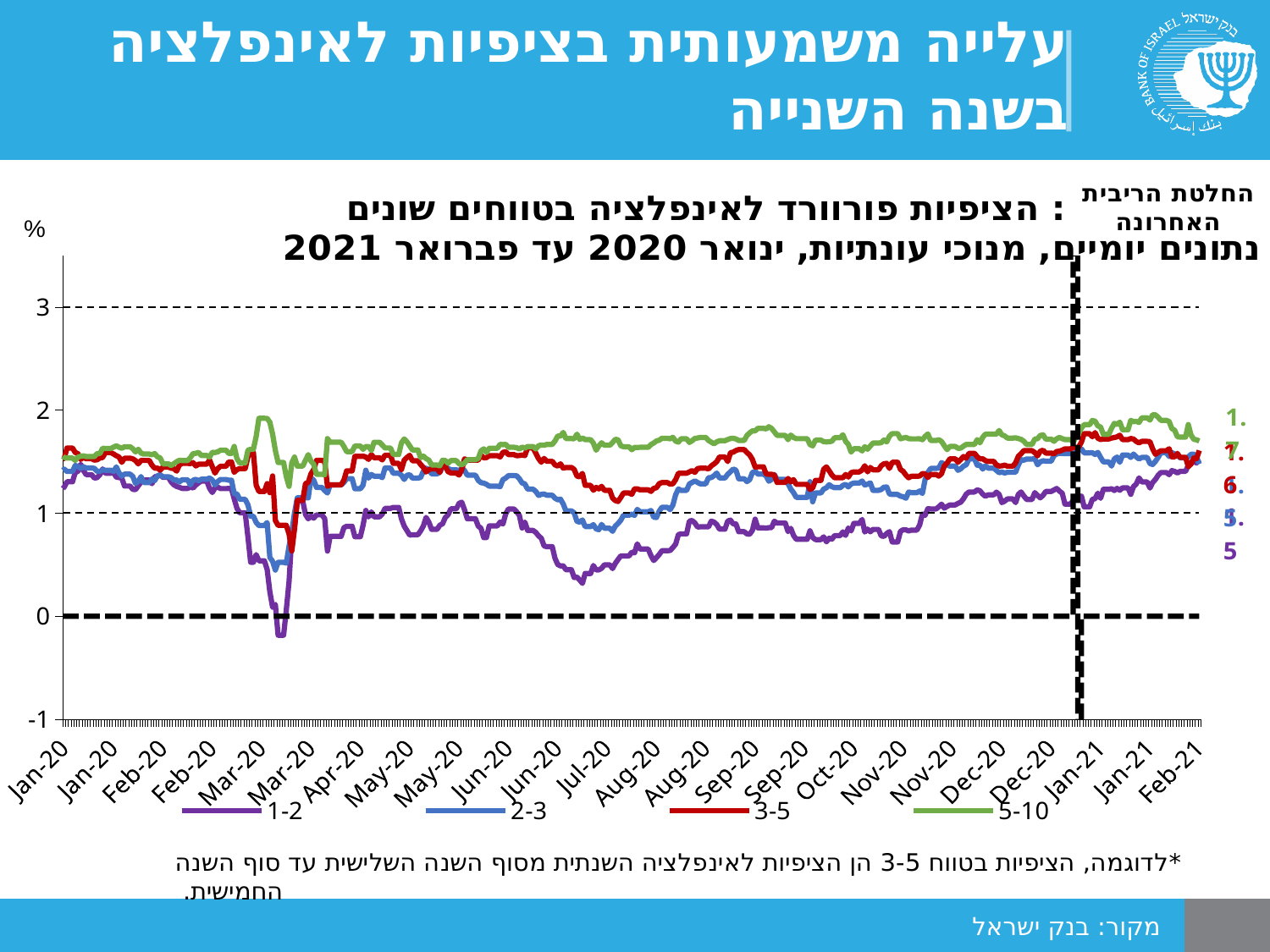
Is the lowest point of the 1-2 series in Mar-20 greater or less than 0? less Is the value of the 1-2 series in Jul-20 greater or less than 1? less What are the four series names listed in the legend? 1-2, 2-3, 3-5, 5-10 How many series does the legend list? 4 Is the highest value of the 5-10 series greater or less than 3? less In Jul-20, which series has the larger value, 1-2 or 5-10? 5-10 From Jul-20 to Feb-21, does the 1-2 series generally rise or fall? rise Which series is the highest for most of the period shown? 5-10 What kind of chart is shown on the slide? line chart Which series is the lowest for most of the period shown? 1-2 What unit is shown on the y-axis? %